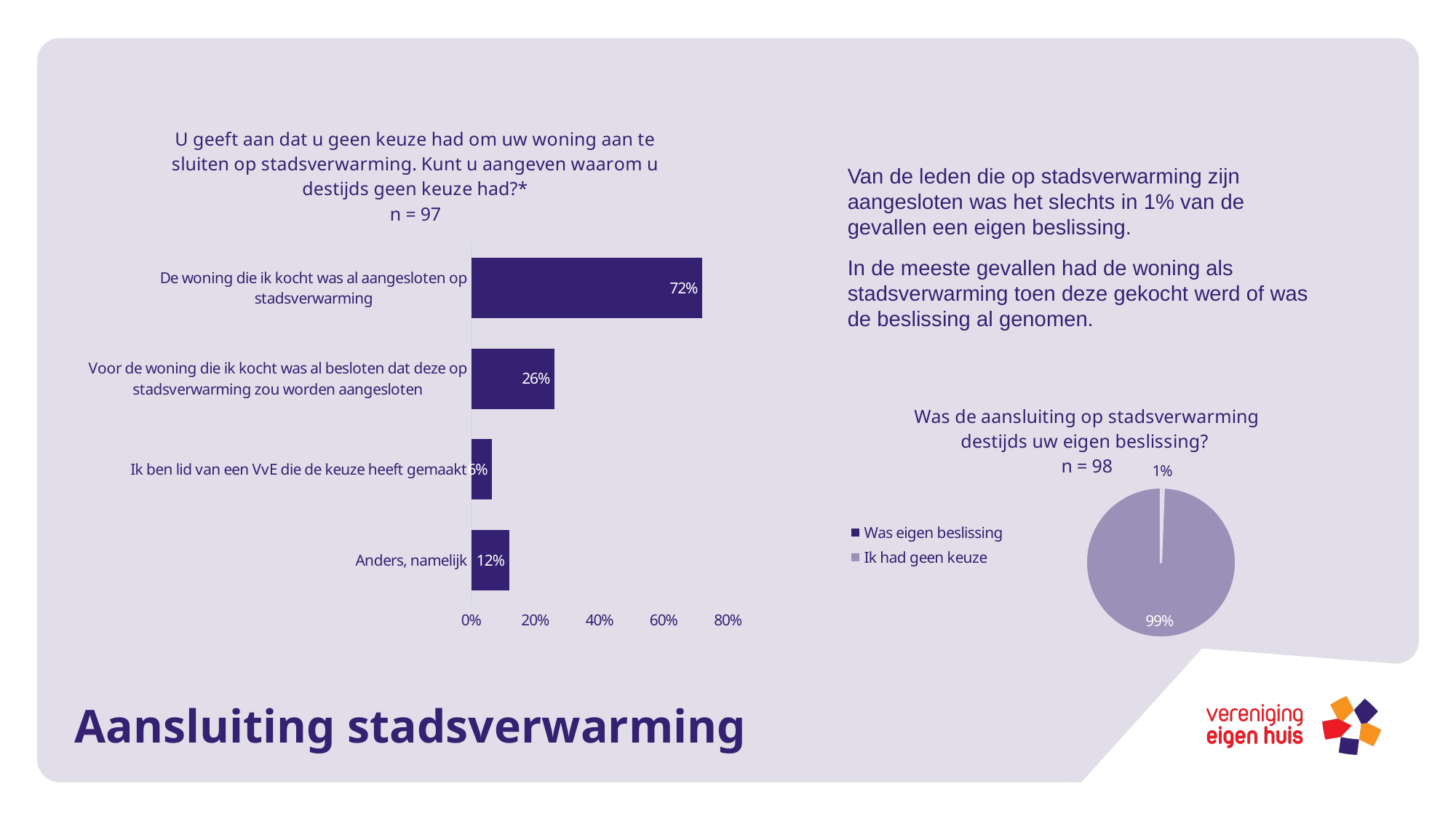
In the pie chart 'Was de aansluiting op stadsverwarming destijds uw eigen beslissing?', what share is 'Was eigen beslissing'? 1% In the bar chart on the left, which category has the lowest value? Ik ben lid van een VvE die de keuze heeft gemaakt How many entries does the legend of the pie chart on the right list? 2 In the bar chart on the left, what is the value for 'Anders, namelijk'? 12% In the bar chart on the left, how many categories are shown? 4 In the bar chart on the left, what is the difference between the values for 'De woning die ik kocht was al aangesloten op stadsverwarming' and 'Voor de woning die ik kocht was al besloten dat deze op stadsverwarming zou worden aangesloten'? 46% In the bar chart on the left, what is the value for 'Voor de woning die ik kocht was al besloten dat deze op stadsverwarming zou worden aangesloten'? 26% In the bar chart on the left, which category has the highest value? De woning die ik kocht was al aangesloten op stadsverwarming In the bar chart on the left, is the value for 'Ik ben lid van een VvE die de keuze heeft gemaakt' greater or less than 20%? less In the pie chart 'Was de aansluiting op stadsverwarming destijds uw eigen beslissing?', what share is 'Ik had geen keuze'? 99% What kind of chart is the chart on the left of the slide? bar chart In the bar chart on the left, what is the value for 'De woning die ik kocht was al aangesloten op stadsverwarming'? 72%